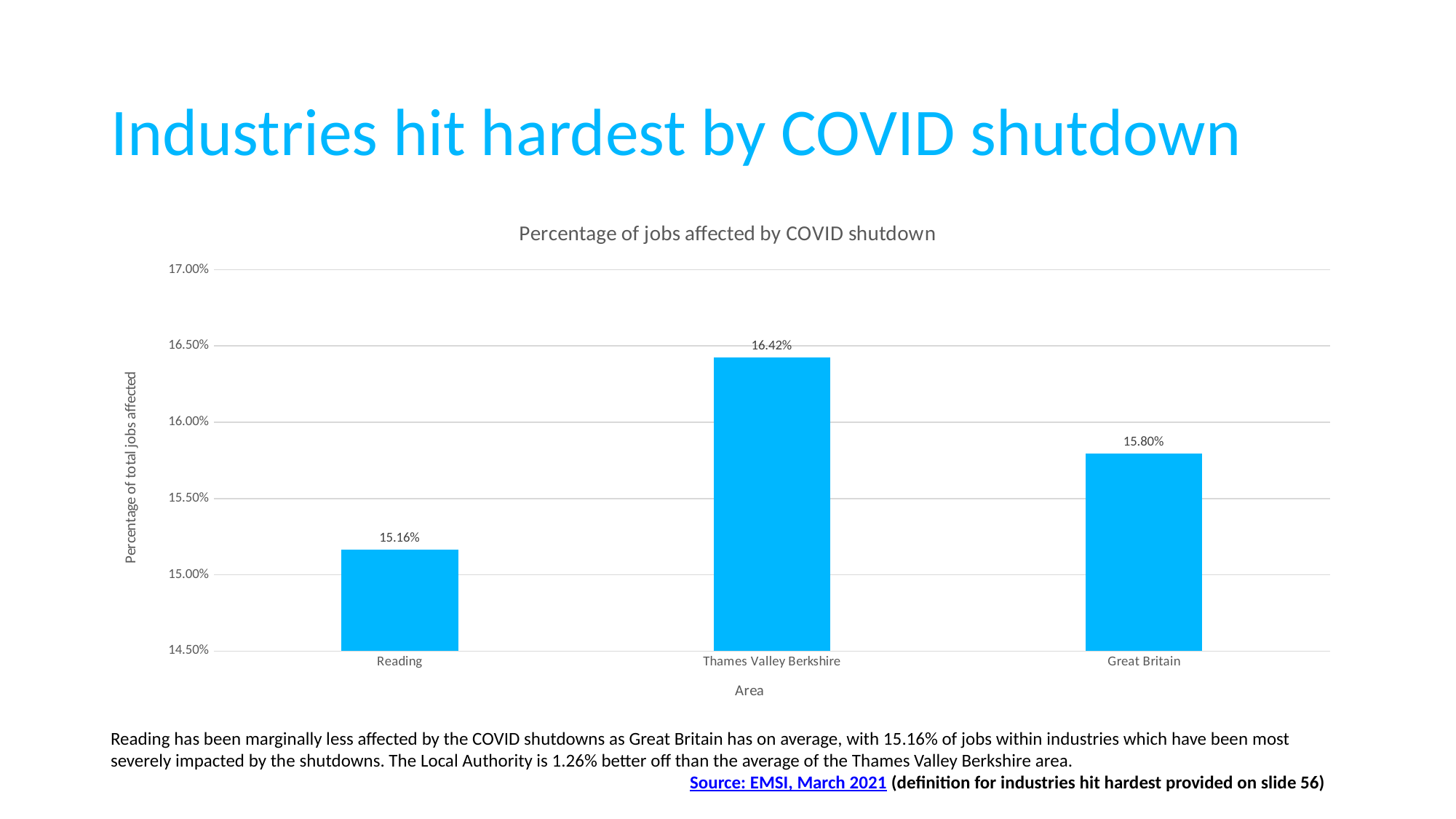
What is the value for Reading? 15.16% How many areas are shown in the chart? 3 What kind of chart is shown on the slide? Bar chart Which area has the highest percentage of jobs affected? Thames Valley Berkshire What is the value for Great Britain? 15.80% What is the value for Thames Valley Berkshire? 16.42% What is the difference between the values for Great Britain and Reading? 0.64% What is the title of the chart? Percentage of jobs affected by COVID shutdown What is the difference between the values for Thames Valley Berkshire and Reading? 1.26% Is the value for Thames Valley Berkshire greater or less than 16.00%? greater Which area has the lowest percentage of jobs affected? Reading Which is larger, the value for Great Britain or the value for Reading? Great Britain